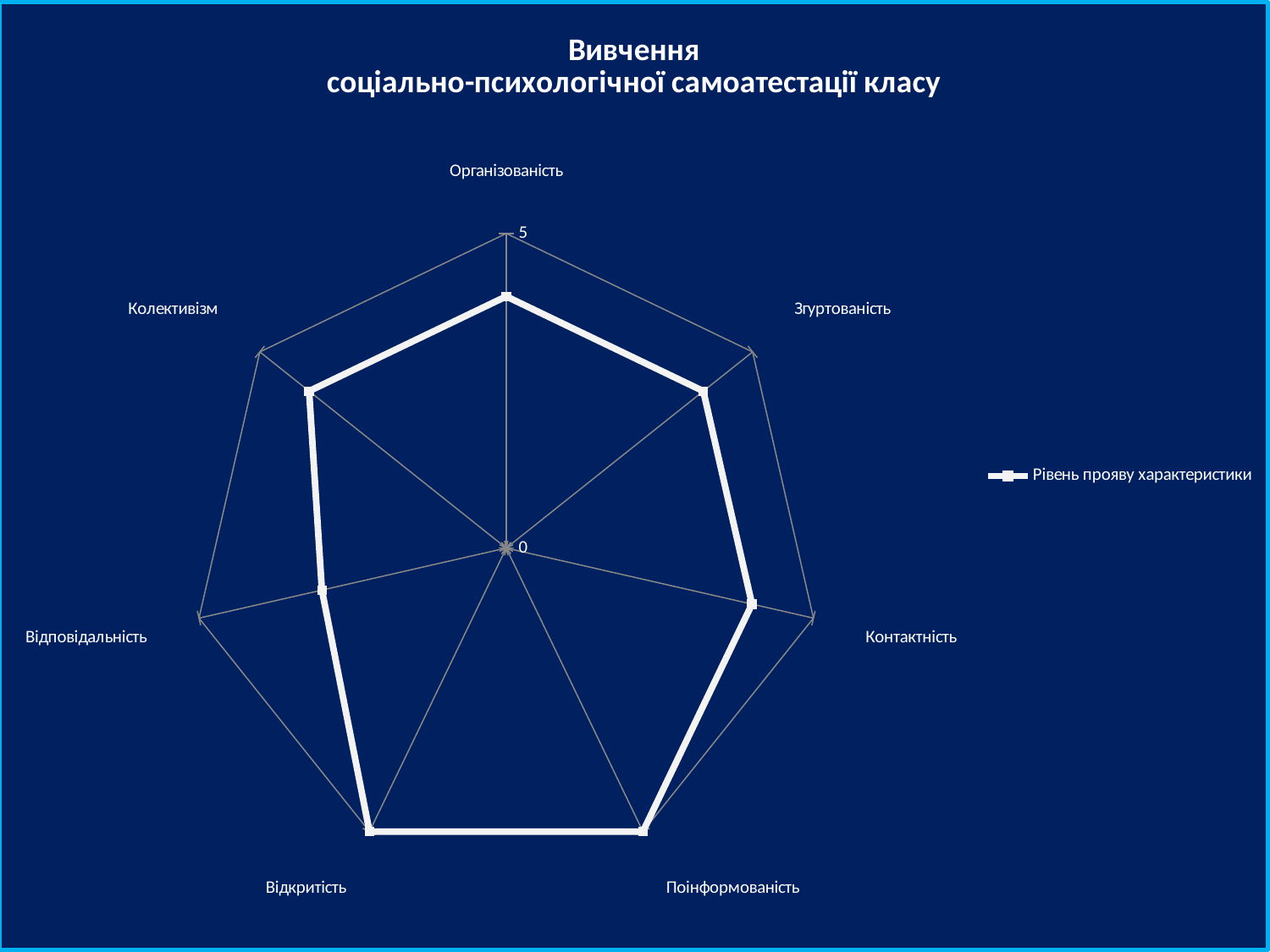
What is the value for Поінформованість? 5 Which is larger, the value for Поінформованість or the value for Відповідальність? Поінформованість What is the name of the series shown in the legend? Рівень прояву характеристики What is the maximum value shown on the radar chart's axis scale? 5 Which is larger, the value for Контактність or the value for Відповідальність? Контактність What is the value for Відкритість? 5 Is the value for Відповідальність greater or less than 5? less How many series does the legend list? 1 What kind of chart is shown on the slide? Radar chart How many categories (axes) does the radar chart have? 7 Which category has the lowest value? Відповідальність What is the title of the chart? Вивчення соціально-психологічної самоатестації класу